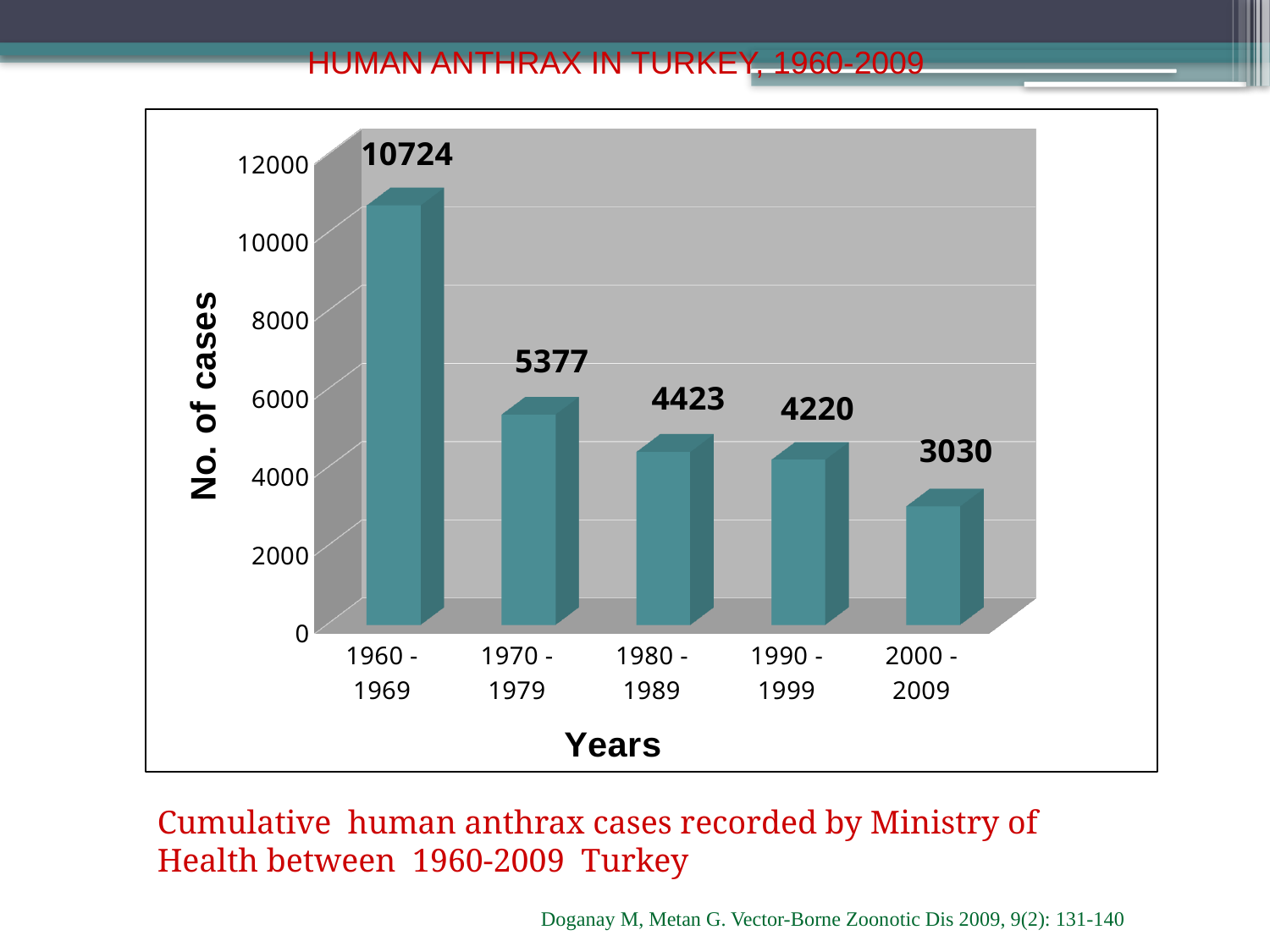
What is the number of cases shown for 1970-1979? 5377 How many decade categories are shown on the x axis? 5 What is the number of cases shown for 2000-2009? 3030 What is the difference in cases between 1980-1989 and 1990-1999? 203 Do the number of cases rise or fall across the decades from 1960-1969 to 2000-2009? Fall What kind of chart is shown on the slide? Bar chart Which decade has the lowest number of cases? 2000 - 2009 Is the value for 1990-1999 greater or less than 4000? greater Which has more cases, 1980-1989 or 2000-2009? 1980 - 1989 What is the difference in cases between 1960-1969 and 1970-1979? 5347 How many human anthrax cases were recorded in Turkey in 1960-1969? 10724 Which decade has the highest number of cases? 1960 - 1969